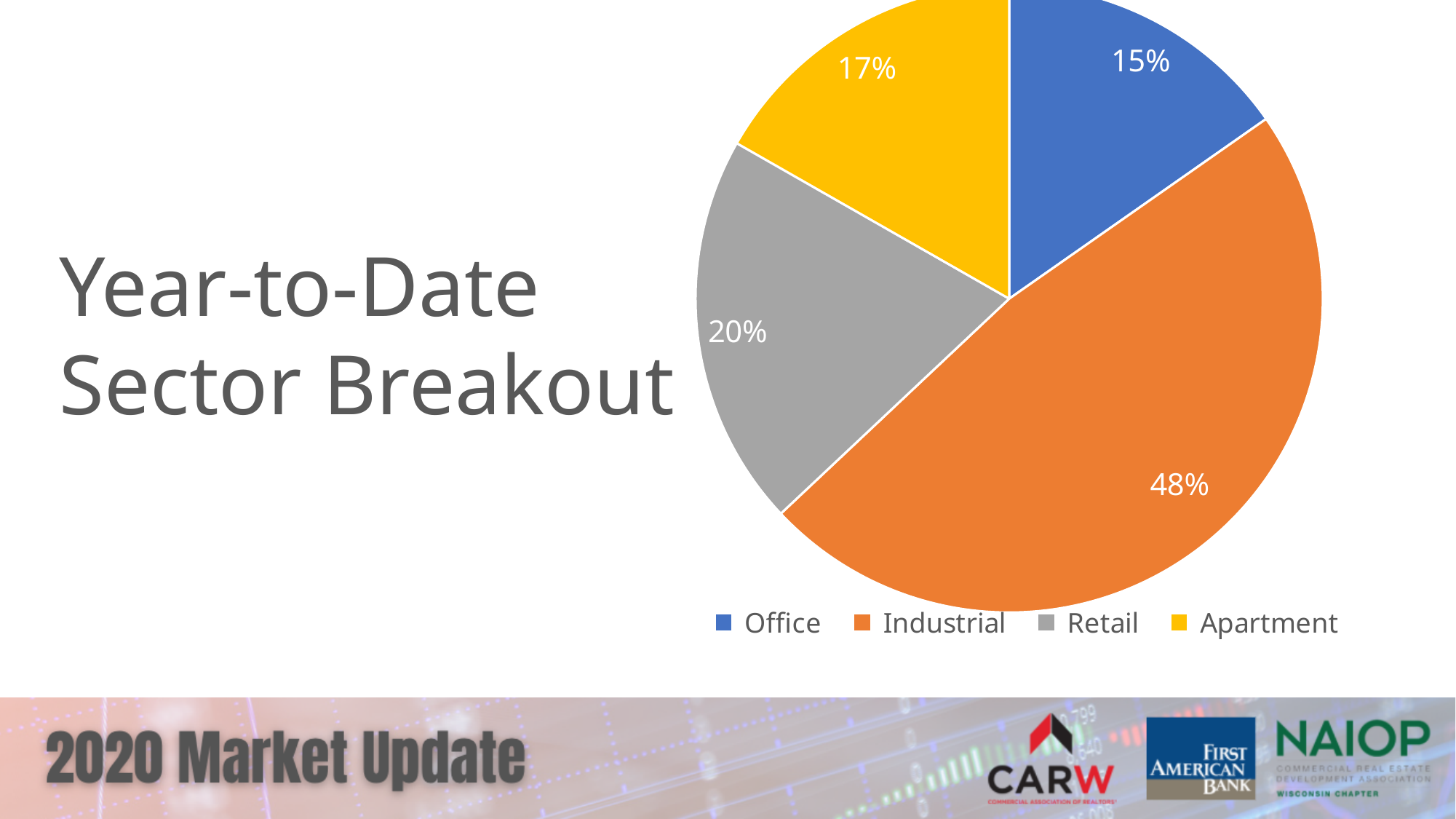
What type of chart is shown on the slide? Pie chart What percentage is shown for the Office slice? 15% Which slice is larger, Retail or Apartment? Retail What percentage is shown for the Apartment slice? 17% What share of the pie does Industrial account for? 48% Which sector has the smallest share of the pie? Office What colour is the Industrial slice in the pie chart? Orange What is the difference in percentage points between the Industrial and Retail slices? 28 Which sector has the largest share of the pie? Industrial What is the difference in percentage points between the Apartment and Office slices? 2 What percentage is shown for the Retail slice? 20% How many sectors are shown in the pie chart? 4